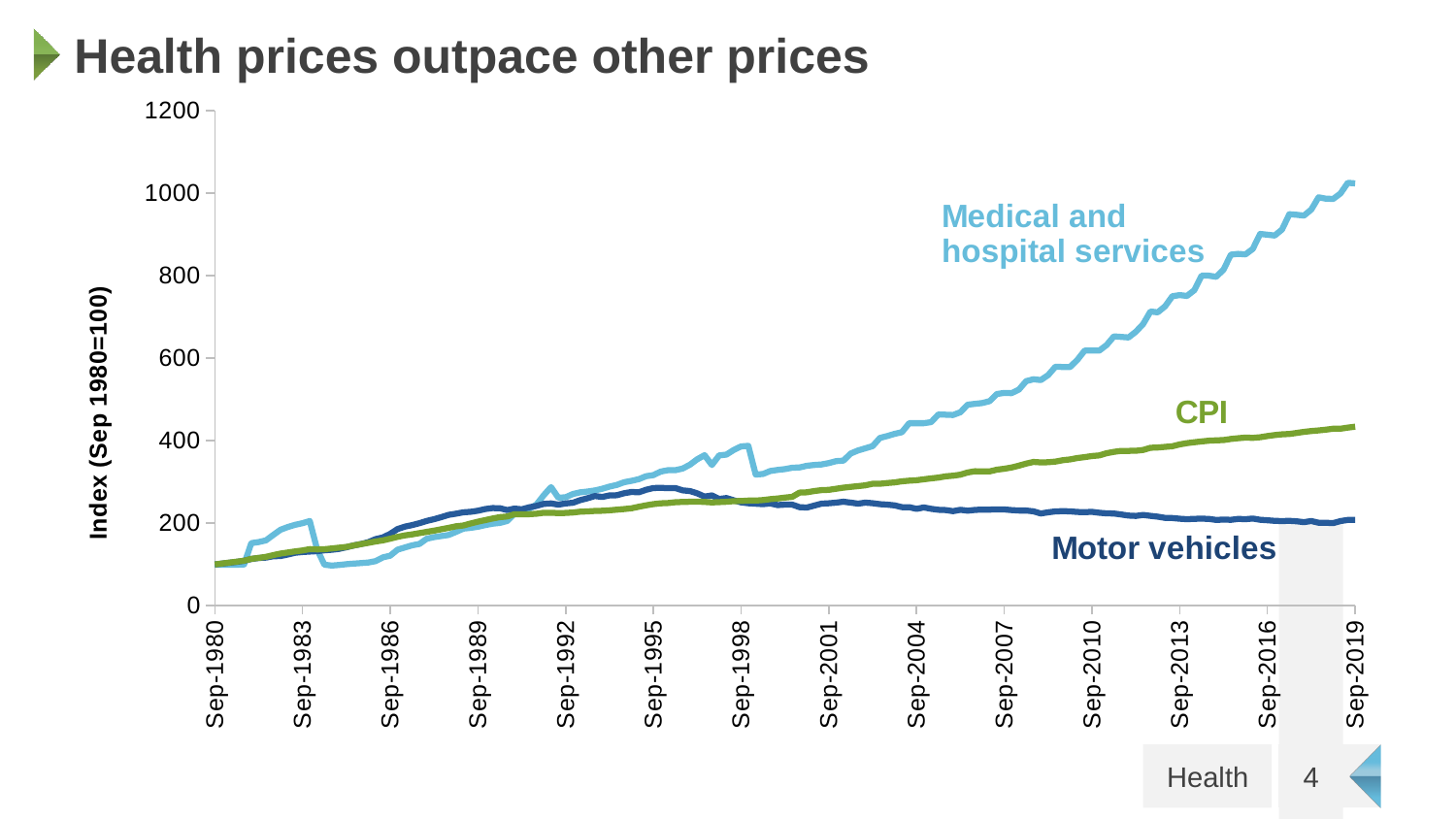
Is the value for CPI at Sep-2019 greater or less than 400? greater Does the Medical and hospital services series rise or fall from Sep-1980 to Sep-2019? Rise Which series has the lowest value at Sep-2019? Motor vehicles Is the value for Motor vehicles at Sep-2019 greater or less than 400? less Which series has the highest value at Sep-2019? Medical and hospital services At Sep-2019, which is larger: CPI or Motor vehicles? CPI Is the value for Medical and hospital services at Sep-2019 greater or less than 800? greater What kind of chart is shown on the slide? Line chart What is the title of the slide? Health prices outpace other prices What is the label on the y axis? Index (Sep 1980=100) How many series are plotted on the chart? 3